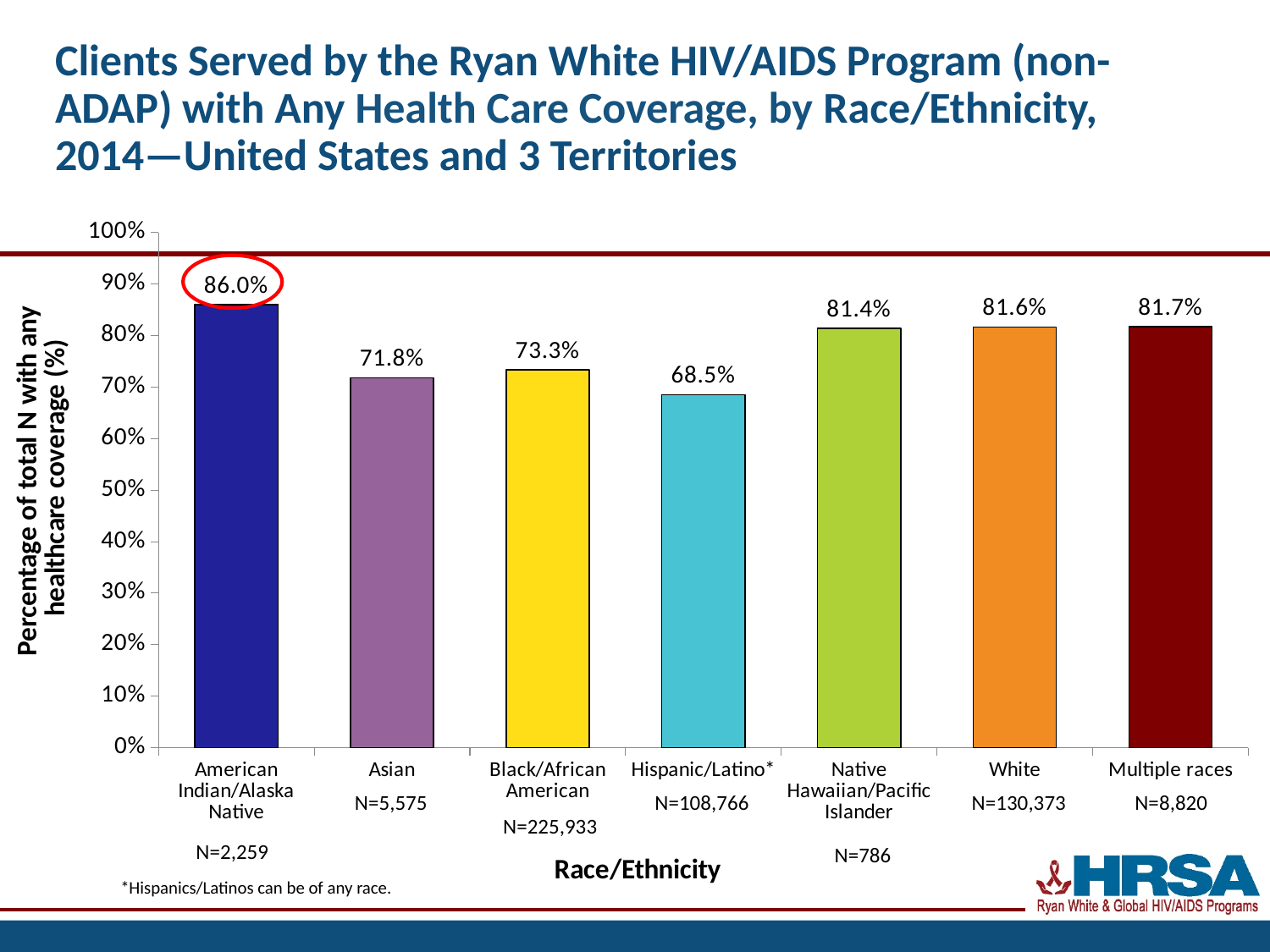
What is the value shown for Hispanic/Latino clients? 68.5% Which race/ethnicity group has the lowest percentage with healthcare coverage? Hispanic/Latino What percentage is shown for White clients? 81.6% What is the difference between the percentages for Black/African American and Asian clients? 1.5% Which has a higher percentage with coverage, Asian or Black/African American clients? Black/African American How many race/ethnicity categories are shown on the chart? 7 Is the value for Native Hawaiian/Pacific Islander greater or less than 80%? greater What is the difference between the percentages for American Indian/Alaska Native and Hispanic/Latino clients? 17.5% What type of chart is shown on the slide? Bar chart What is the label of the y-axis? Percentage of total N with any healthcare coverage (%) Which race/ethnicity group has the highest percentage with healthcare coverage? American Indian/Alaska Native What percentage of American Indian/Alaska Native clients have any healthcare coverage? 86.0%